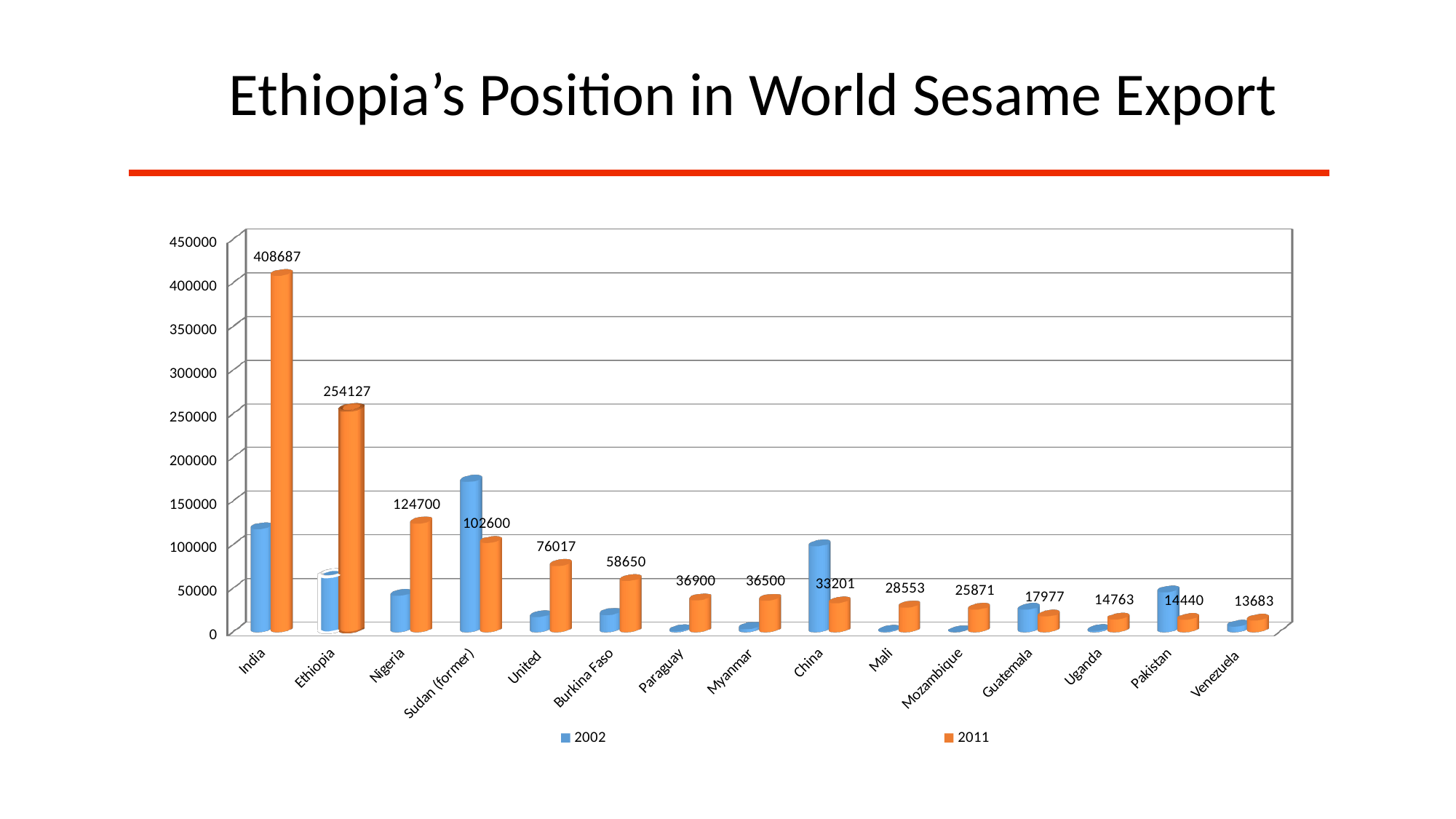
For Sudan (former), which year has the larger value, 2002 or 2011? 2002 Which country has the highest 2011 value? India Which country has the lowest 2011 value? Venezuela What type of chart is shown on the slide? Bar chart What is the 2011 value for Venezuela? 13683 What is the 2011 value for Burkina Faso? 58650 What is the difference between the 2011 values for India and Ethiopia? 154560 Is the 2002 value for Sudan (former) greater or less than 150000? greater What is the 2011 value for Ethiopia? 254127 How many countries are shown on the x axis? 15 What is the difference between the 2011 values for Nigeria and Sudan (former)? 22100 How many series does the legend list? 2